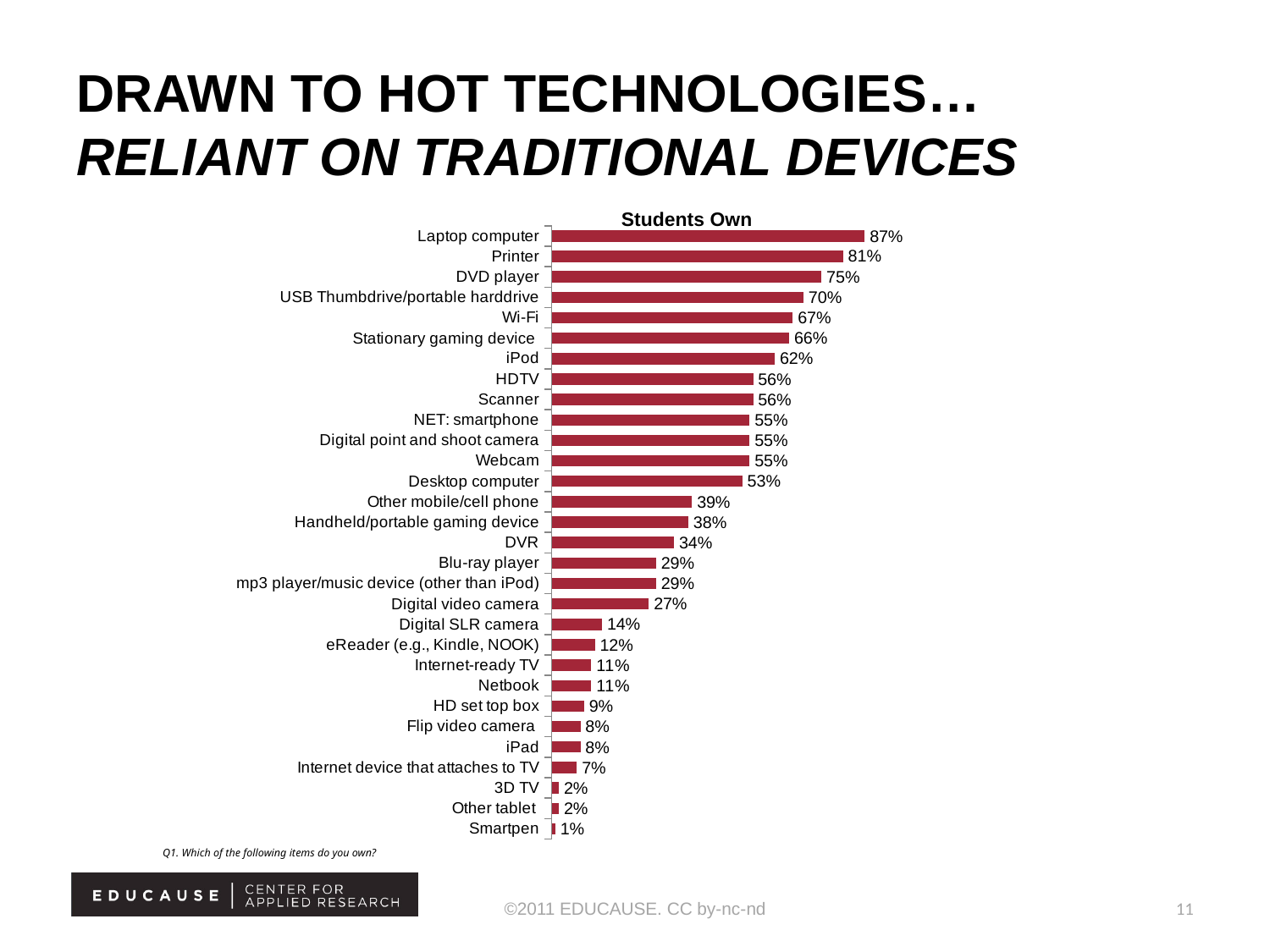
What is the difference between the values for iPod and Netbook? 51% What is the value shown for iPad? 8% What percentage of students own a laptop computer? 87% Which item has the lowest ownership percentage? Smartpen What percentage of students own a desktop computer? 53% What type of chart is shown on the slide? Bar chart What is the difference between the percentage for Printer and the percentage for DVD player? 6% What is the title of the chart? Students Own Which is larger, the value for Wi-Fi or the value for DVR? Wi-Fi How many items are listed in the chart? 30 Which item has the highest ownership percentage? Laptop computer What is the value for eReader (e.g., Kindle, NOOK)? 12%